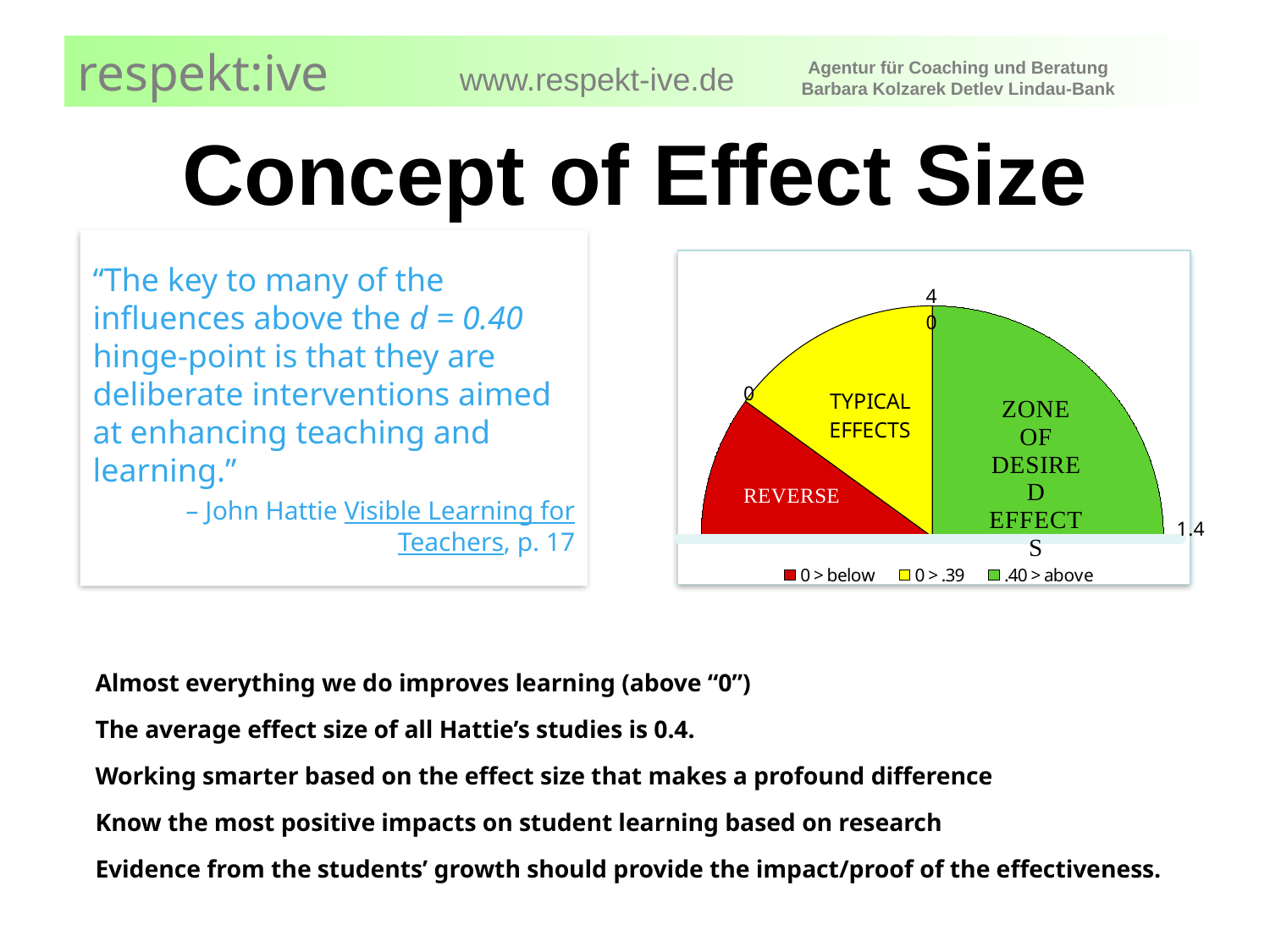
What colour is the REVERSE segment of the chart? red Which segment of the chart is the largest? ZONE OF DESIRED EFFECTS How many entries does the chart's legend list? 3 Which legend entry corresponds to the green segment of the chart? .40 > above Which segment of the chart is the smallest? REVERSE What value is printed at the right end of the chart's arc? 1.4 What is the label of the yellow segment of the chart? TYPICAL EFFECTS Which segment is larger, TYPICAL EFFECTS or ZONE OF DESIRED EFFECTS? ZONE OF DESIRED EFFECTS What kind of chart is shown on the slide? pie chart How many segments does the chart have? 3 Which segment is larger, REVERSE or TYPICAL EFFECTS? TYPICAL EFFECTS